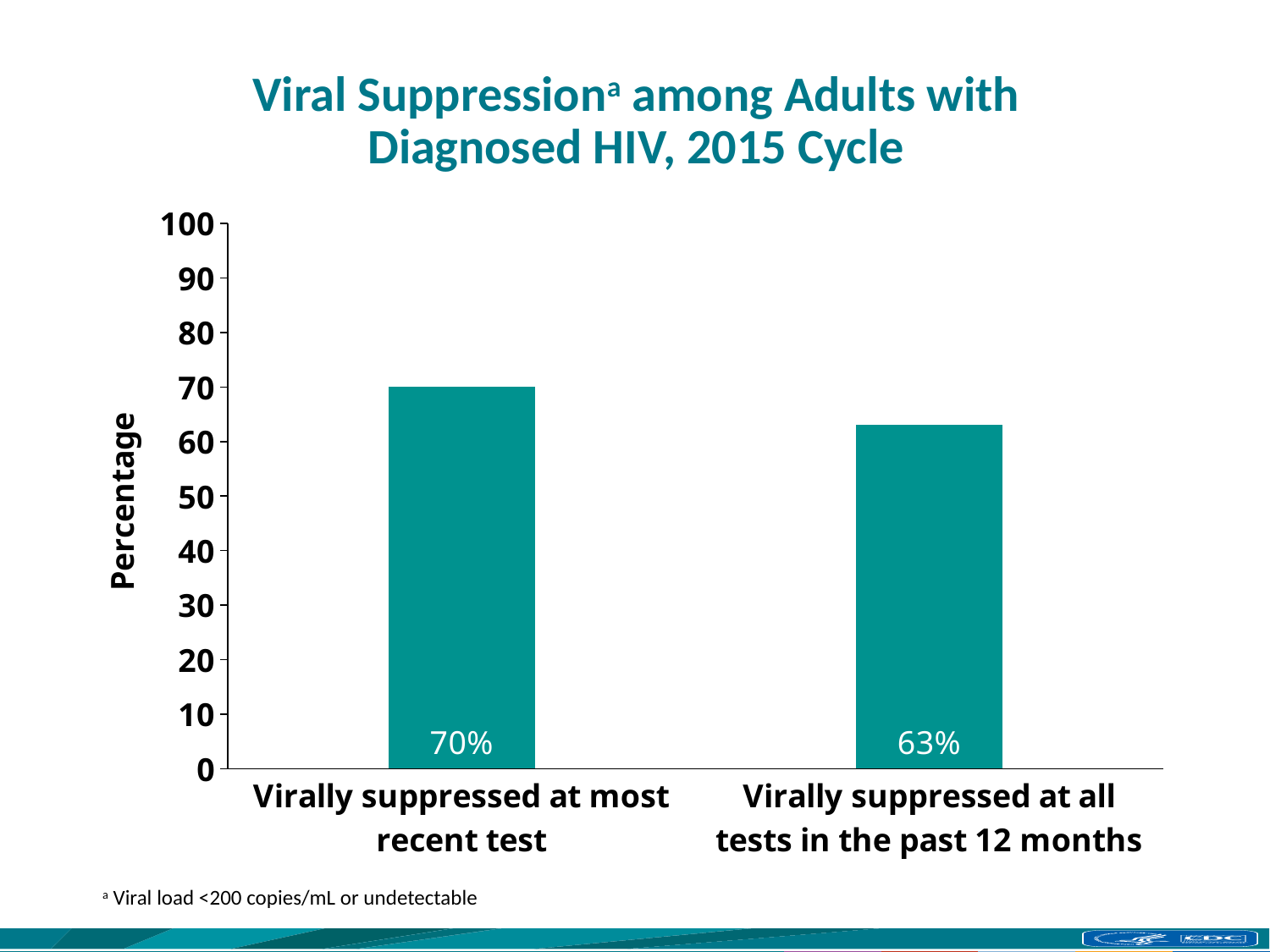
Which category has the higher percentage? Virally suppressed at most recent test Is the value for virally suppressed at all tests in the past 12 months greater or less than 50? greater What is the difference in percentage points between virally suppressed at most recent test and virally suppressed at all tests in the past 12 months? 7 What percentage of adults with diagnosed HIV were virally suppressed at most recent test? 70% Which category has the lower percentage? Virally suppressed at all tests in the past 12 months Is the value for virally suppressed at most recent test greater or less than 80? less What kind of chart is shown on the slide? Bar chart Is the percentage for virally suppressed at most recent test larger or smaller than the percentage for virally suppressed at all tests in the past 12 months? larger What is the title of the chart? Viral Suppression among Adults with Diagnosed HIV, 2015 Cycle What percentage of adults with diagnosed HIV were virally suppressed at all tests in the past 12 months? 63% How many categories are shown in the chart? 2 What is the label of the y axis? Percentage